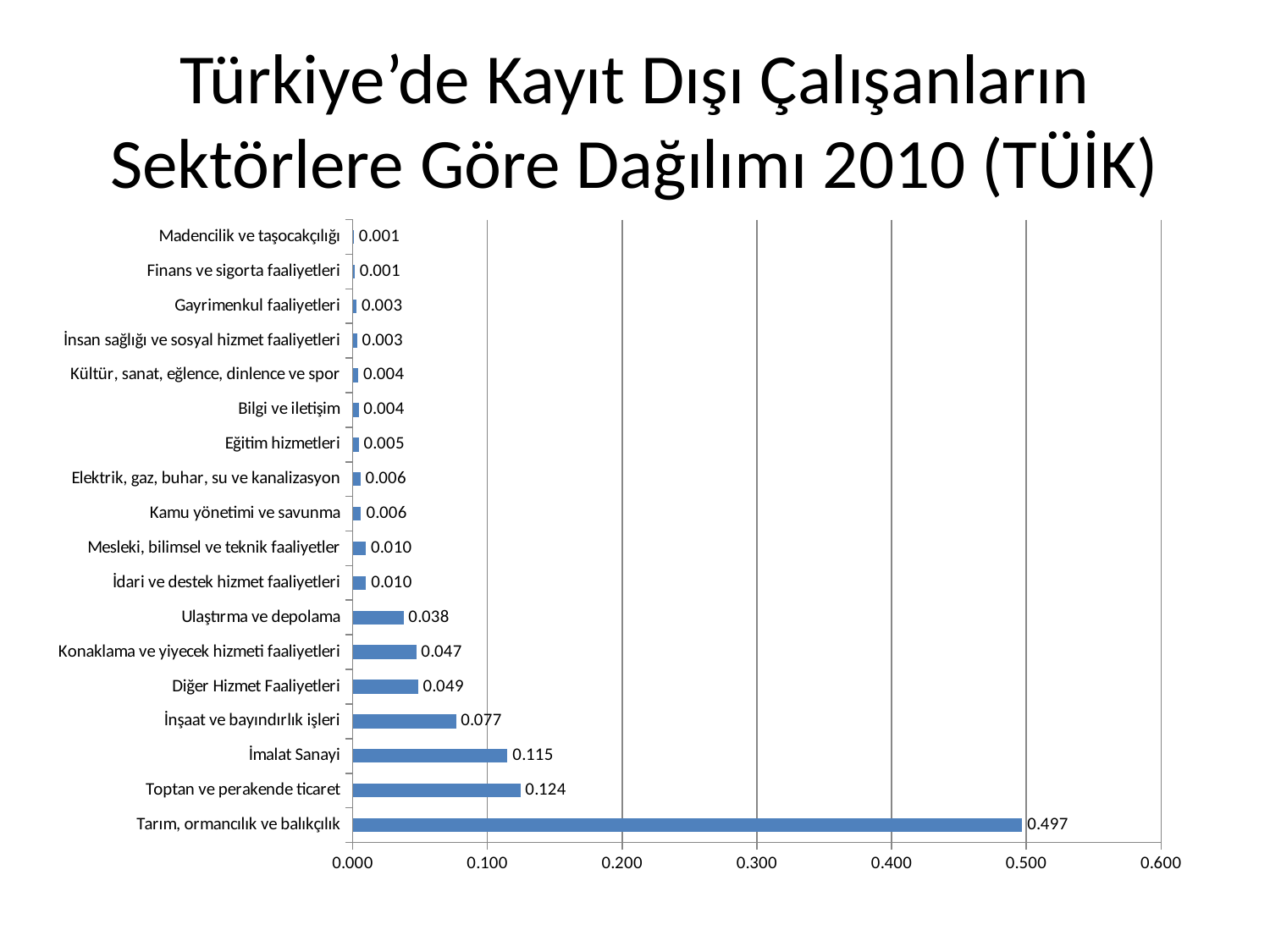
What is the value for İmalat Sanayi? 0.115 What is the difference between the values for Tarım, ormancılık ve balıkçılık and Toptan ve perakende ticaret? 0.373 Which sector has the highest value? Tarım, ormancılık ve balıkçılık Which is larger, the value for İnşaat ve bayındırlık işleri or the value for Diğer Hizmet Faaliyetleri? İnşaat ve bayındırlık işleri What is the title of the slide? Türkiye'de Kayıt Dışı Çalışanların Sektörlere Göre Dağılımı 2010 (TÜİK) What is the value for Eğitim hizmetleri? 0.005 What is the value for Tarım, ormancılık ve balıkçılık? 0.497 What is the difference between the values for Toptan ve perakende ticaret and İmalat Sanayi? 0.009 What kind of chart is shown on the slide? bar chart How many sectors are shown in the chart? 18 What is the value for Ulaştırma ve depolama? 0.038 Is the value for Tarım, ormancılık ve balıkçılık greater or less than 0.400? greater